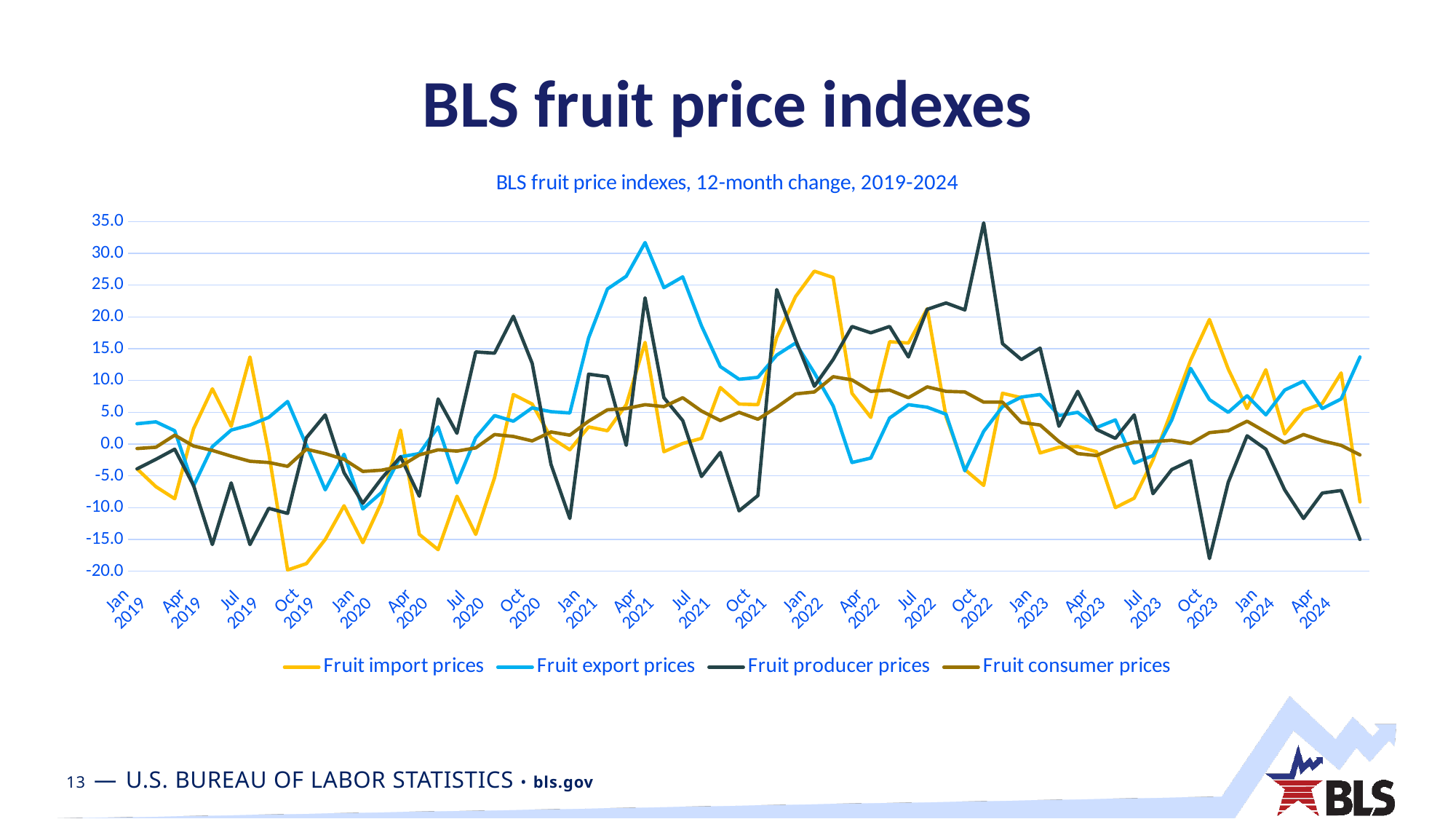
Is the value for Fruit producer prices around Oct 2023 greater or less than -15? less Around Oct 2019, which series is higher: Fruit import prices or Fruit export prices? Fruit export prices How many series does the legend list? 4 Which series is drawn in yellow? Fruit import prices Around Oct 2022, which series is higher: Fruit producer prices or Fruit consumer prices? Fruit producer prices What kind of chart is shown on the slide? Line chart Is the peak value of Fruit export prices around Apr 2021 greater or less than 25? greater Is the value for Fruit import prices around Oct 2019 greater or less than -15? less What is the subtitle printed above the chart? BLS fruit price indexes, 12-month change, 2019-2024 Which series reaches the highest value anywhere on the chart? Fruit producer prices